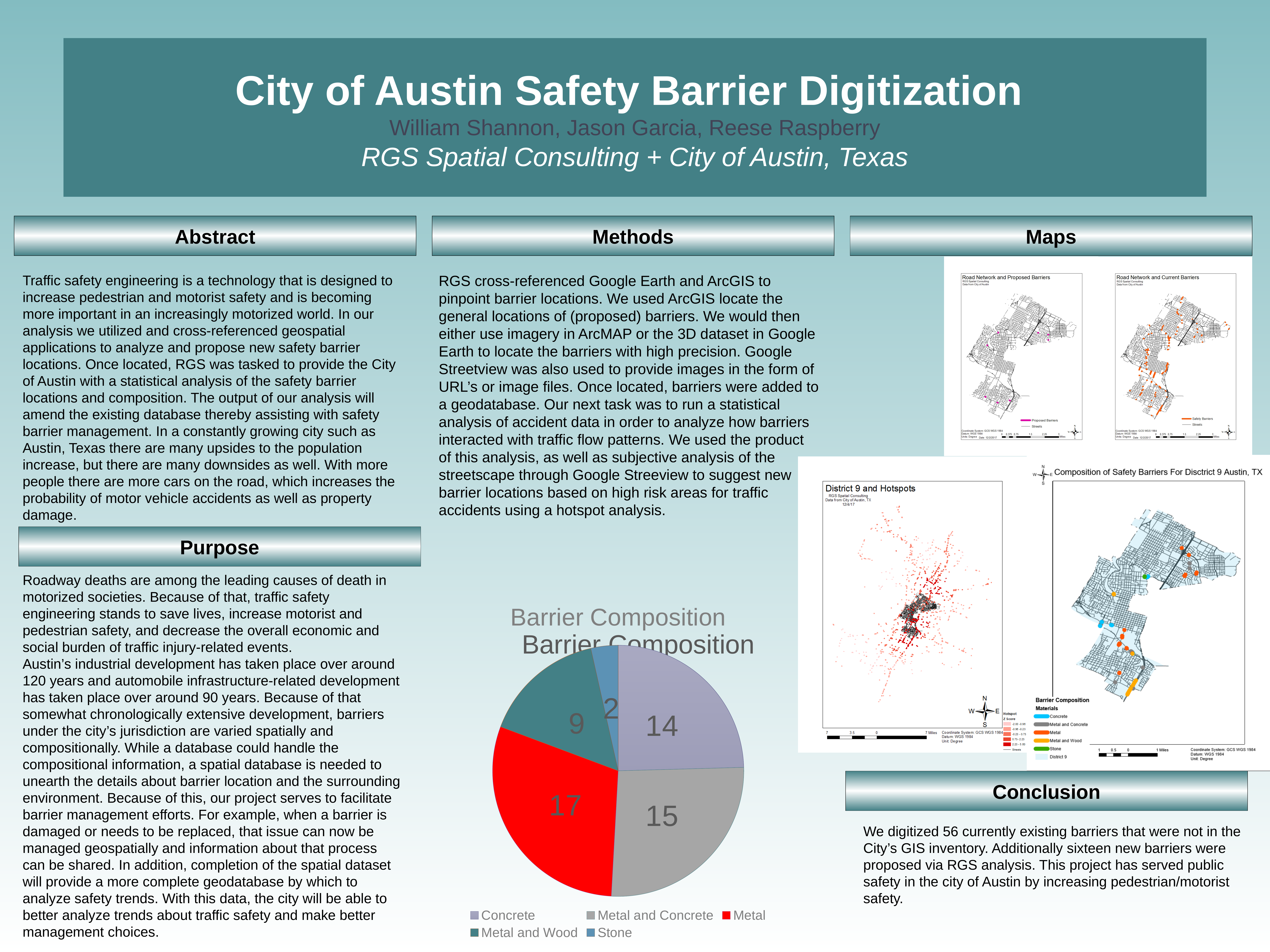
In the Barrier Composition pie chart, what colour is the Metal slice? red In the Barrier Composition pie chart, what is the value for Metal? 17 In the Barrier Composition pie chart, what is the value for Concrete? 14 Which category has the largest slice in the Barrier Composition pie chart? Metal In the Barrier Composition pie chart, what is the value for Stone? 2 What kind of chart is the Barrier Composition chart? pie chart Which category has the smallest slice in the Barrier Composition pie chart? Stone How many categories does the Barrier Composition pie chart show? 5 What is the total of all slices in the Barrier Composition pie chart? 57 In the Barrier Composition pie chart, what is the value for Metal and Wood? 9 In the Barrier Composition pie chart, what is the difference between the values for Metal and Metal and Wood? 8 In the Barrier Composition pie chart, which is larger, Metal and Concrete or Concrete? Metal and Concrete